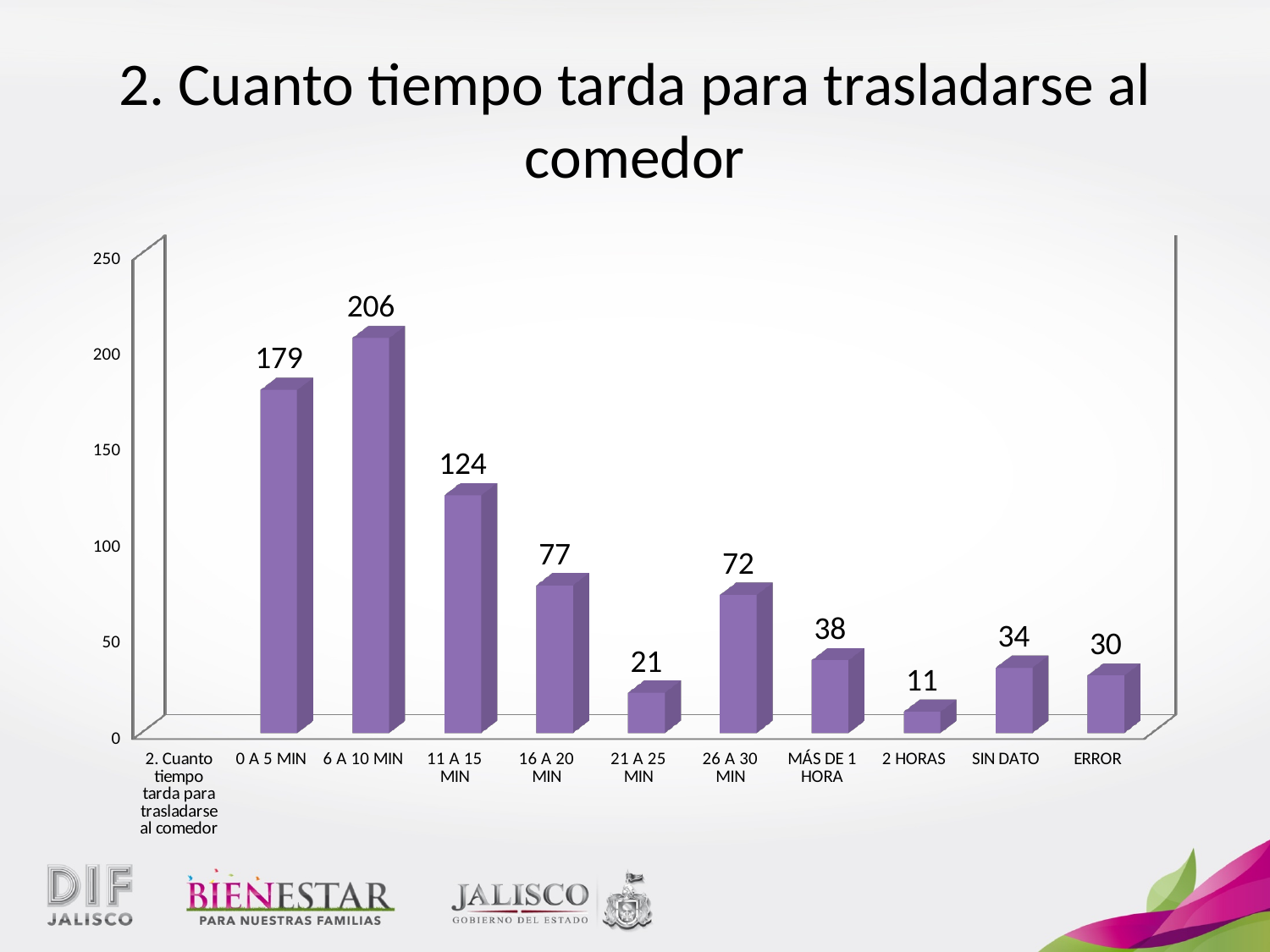
What is the title of the slide? 2. Cuanto tiempo tarda para trasladarse al comedor What is the value for the 2 HORAS category? 11 Which category has the highest value? 6 A 10 MIN What is the value for the SIN DATO category? 34 How many bars are plotted in the chart? 10 What is the value for the 6 A 10 MIN category? 206 What is the difference between the values for 6 A 10 MIN and 0 A 5 MIN? 27 What is the difference between the values for 11 A 15 MIN and 16 A 20 MIN? 47 Which category has the lowest value? 2 HORAS Which is larger, the value for 16 A 20 MIN or the value for 26 A 30 MIN? 16 A 20 MIN What is the value for the 0 A 5 MIN category? 179 What kind of chart is shown on the slide? Bar chart